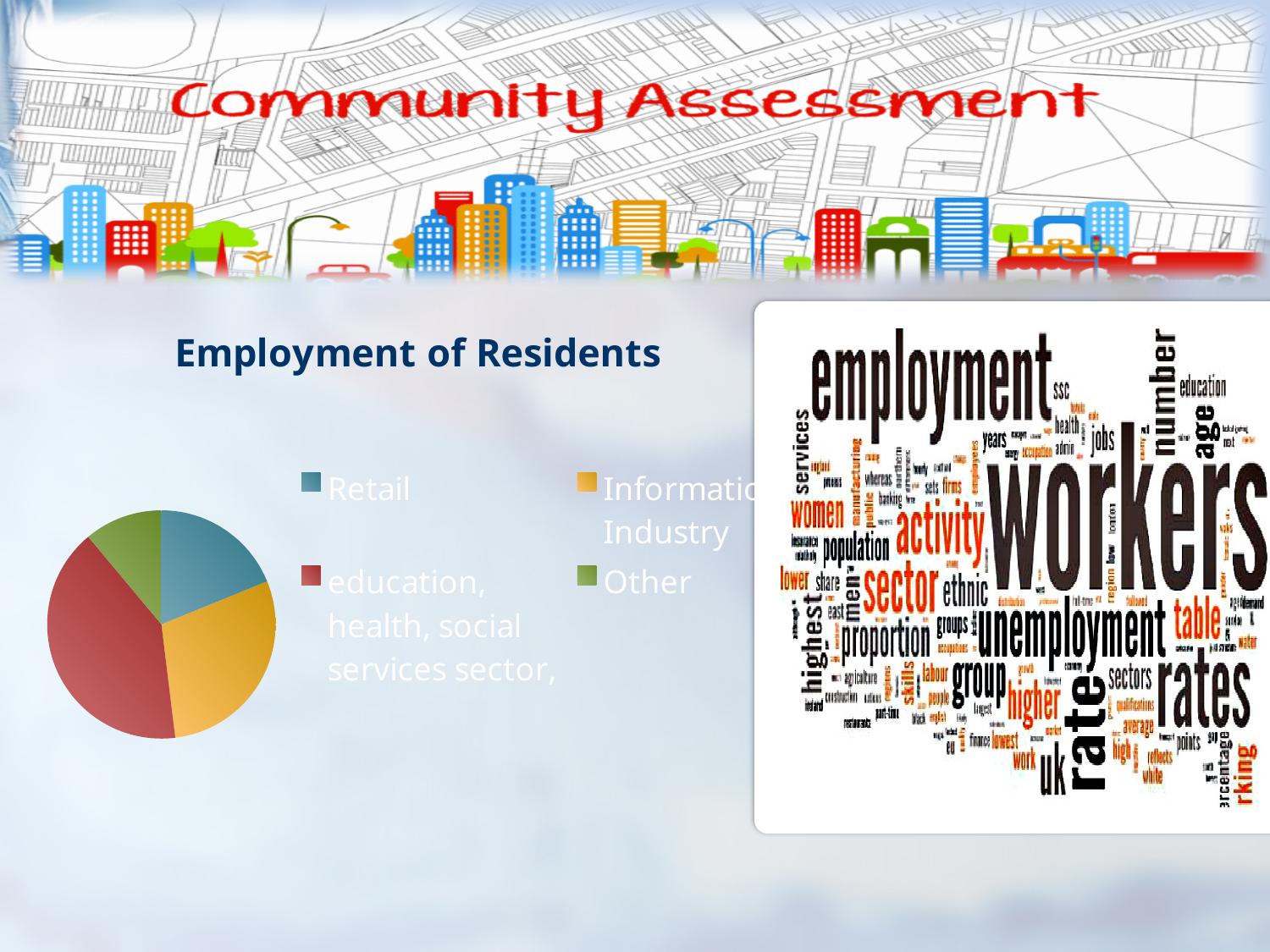
How many entries does the legend of the pie chart list? 4 What is the heading above the pie chart? Employment of Residents Which slice is larger: education, health, social services sector or Other? education, health, social services sector How many slices does the pie chart have? 4 Which category has the largest slice in the pie chart? education, health, social services sector Which slice is larger: Retail or Other? Retail Which slice is larger: Information Industry or Other? Information Industry Which category has the smallest slice in the pie chart? Other What kind of chart is shown on the slide? pie chart What colour is the Retail slice in the pie chart? blue